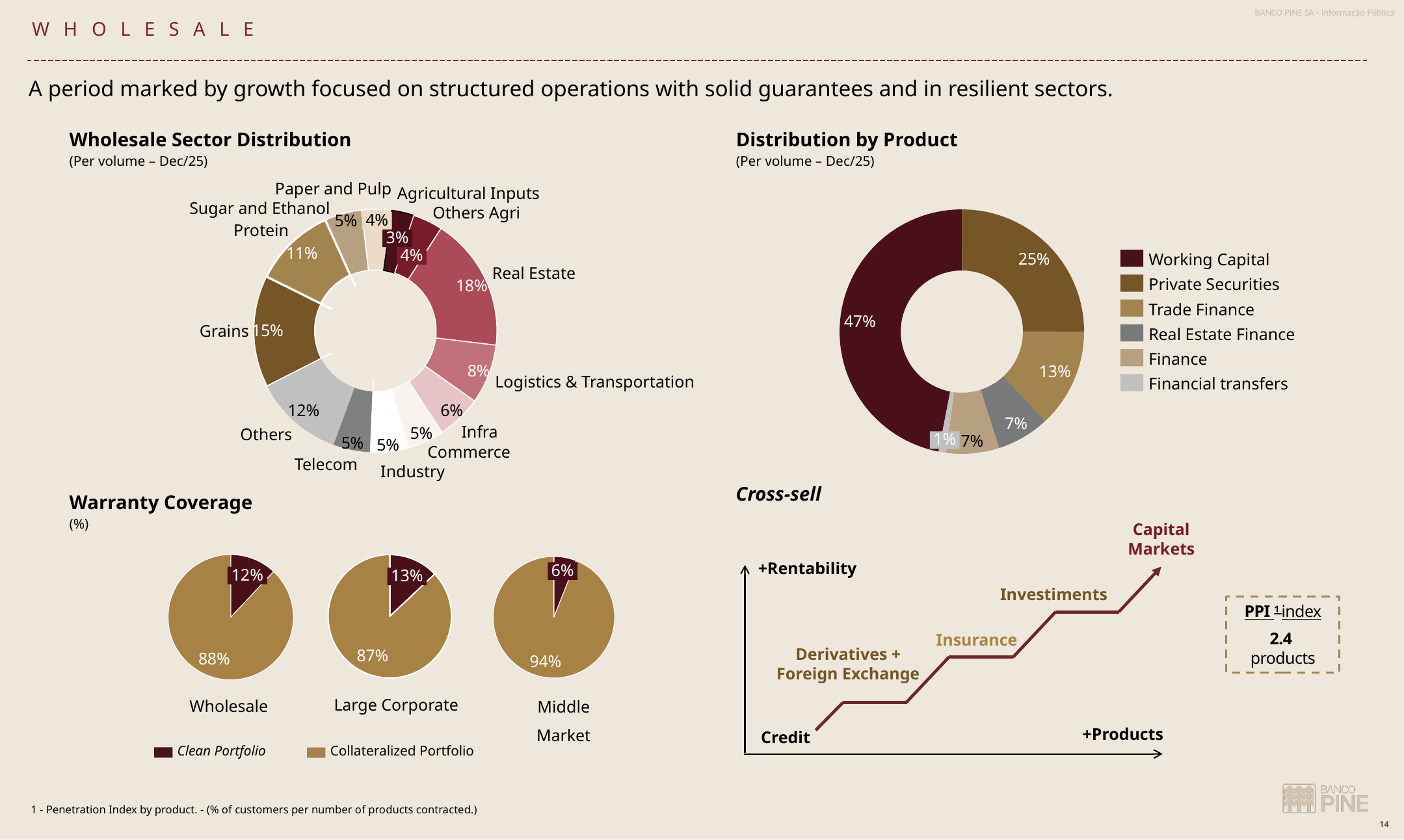
How many entries does the legend of the Distribution by Product chart list? 6 In the Wholesale Sector Distribution chart, what share does Real Estate have? 18% In the Warranty Coverage charts, what is the Clean Portfolio share for Middle Market? 6% In the Distribution by Product chart, which product has the smallest share? Financial transfers In the Wholesale Sector Distribution chart, which is larger, Logistics & Transportation or Others? Others In the Wholesale Sector Distribution chart, what is the difference between the Grains share and the Protein share? 4% In the Wholesale Sector Distribution chart, what share does Grains have? 15% In the Warranty Coverage charts, which segment has the highest Collateralized Portfolio share? Middle Market In the Distribution by Product chart, what is the difference between the Private Securities share and the Trade Finance share? 12% In the Wholesale Sector Distribution chart, which sector has the largest share? Real Estate In the Distribution by Product chart, what share does Working Capital have? 47% What kind of chart is the Distribution by Product chart? Donut chart